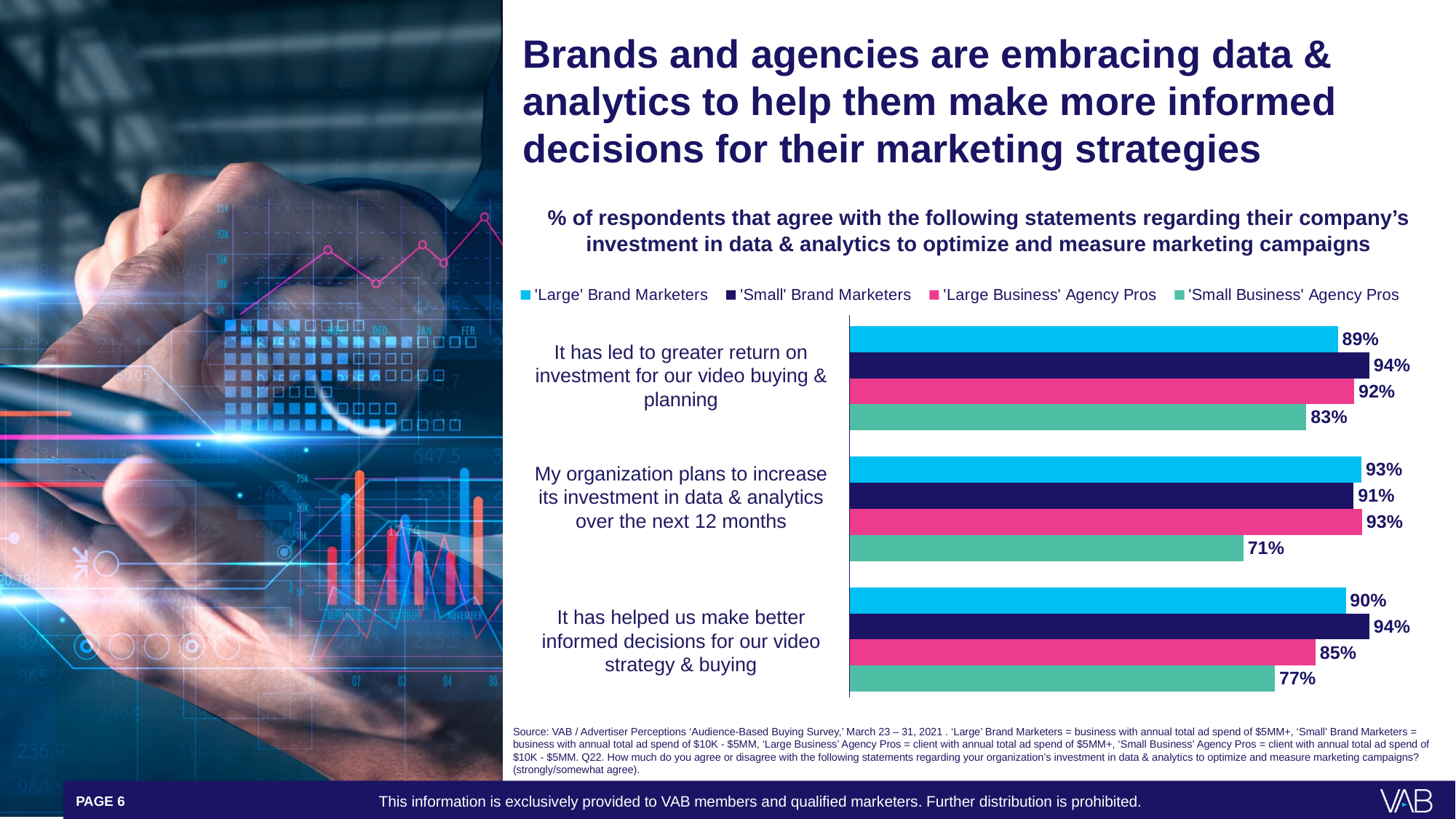
What percentage of 'Large' Brand Marketers agree that it has helped them make better informed decisions for their video strategy & buying? 90% What type of chart is shown on the slide? Bar chart What percentage of 'Small Business' Agency Pros say their organization plans to increase its investment in data & analytics over the next 12 months? 71% How many statements (categories) are shown in the chart? 3 For the statement about greater return on investment for video buying & planning, which group has the higher value: 'Large' Brand Marketers or 'Large Business' Agency Pros? 'Large Business' Agency Pros What is the difference between 'Small' Brand Marketers and 'Small Business' Agency Pros for the statement that it has helped them make better informed decisions for their video strategy & buying? 17 percentage points Which colour represents 'Small Business' Agency Pros in the chart? Green How many respondent groups does the legend list? 4 What percentage of 'Small' Brand Marketers agree that it has led to greater return on investment for their video buying & planning? 94% Which respondent group has the highest agreement that it has led to greater return on investment for their video buying & planning? 'Small' Brand Marketers What percentage of 'Large Business' Agency Pros agree that it has helped them make better informed decisions for their video strategy & buying? 85% Which respondent group has the lowest agreement that their organization plans to increase its investment in data & analytics over the next 12 months? 'Small Business' Agency Pros